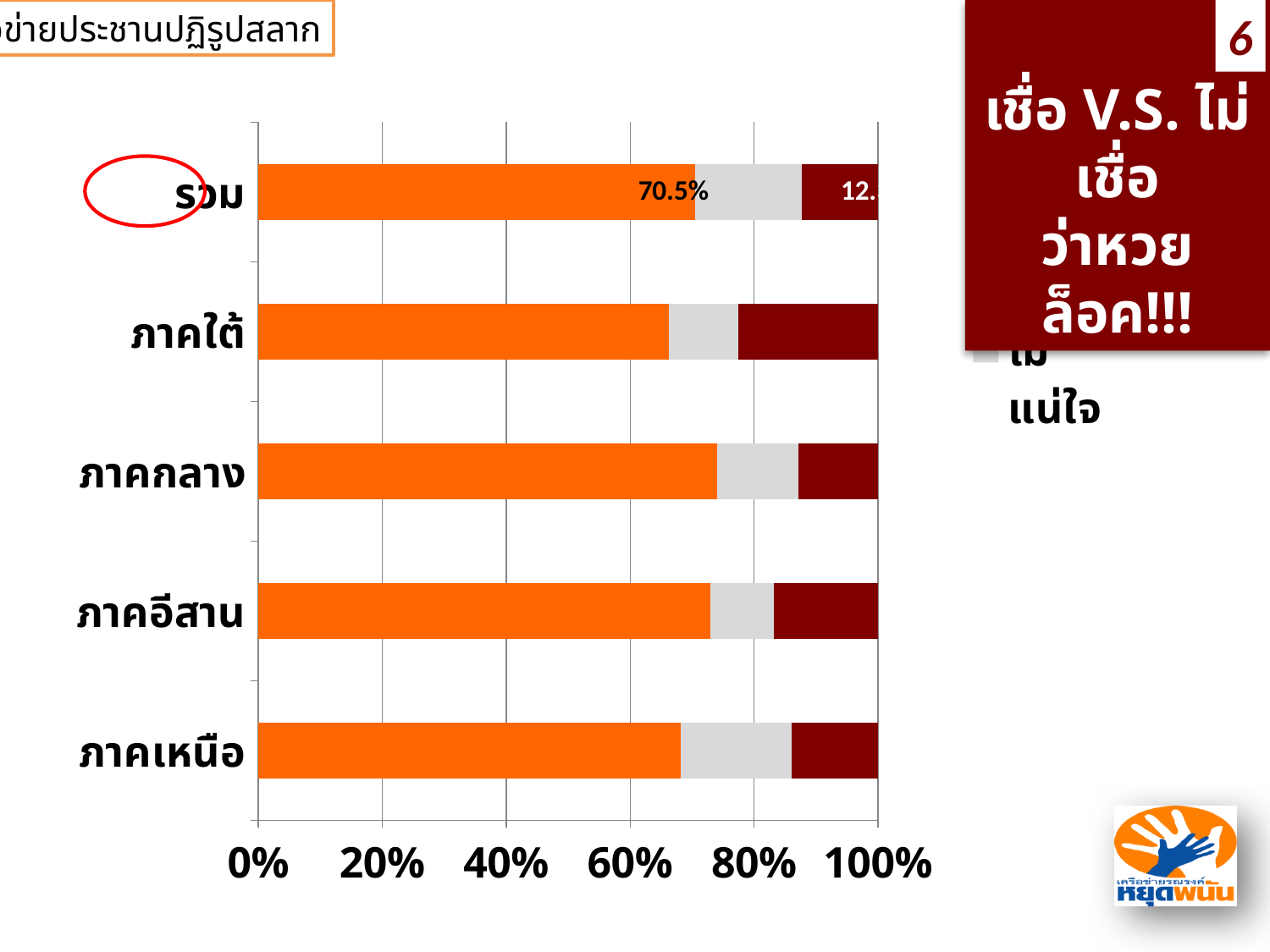
Which category has the largest dark red segment? ภาคใต้ What data label is printed on the orange segment of the รวม bar? 70.5% Is the orange segment of the ภาคใต้ bar greater or less than 80%? less What is the title shown in the dark red box next to the chart? เชื่อ V.S. ไม่เชื่อว่าหวยล็อค!!! What kind of chart is shown on the slide? bar chart Which has the larger orange segment, ภาคกลาง or ภาคใต้? ภาคกลาง Is the orange segment of the ภาคใต้ bar greater or less than 60%? greater Which has the larger orange segment, ภาคกลาง or ภาคเหนือ? ภาคกลาง What is the highest value shown on the horizontal axis of the chart? 100% Is the orange segment of the ภาคเหนือ bar greater or less than 80%? less How many categories are shown on the vertical axis of the chart? 5